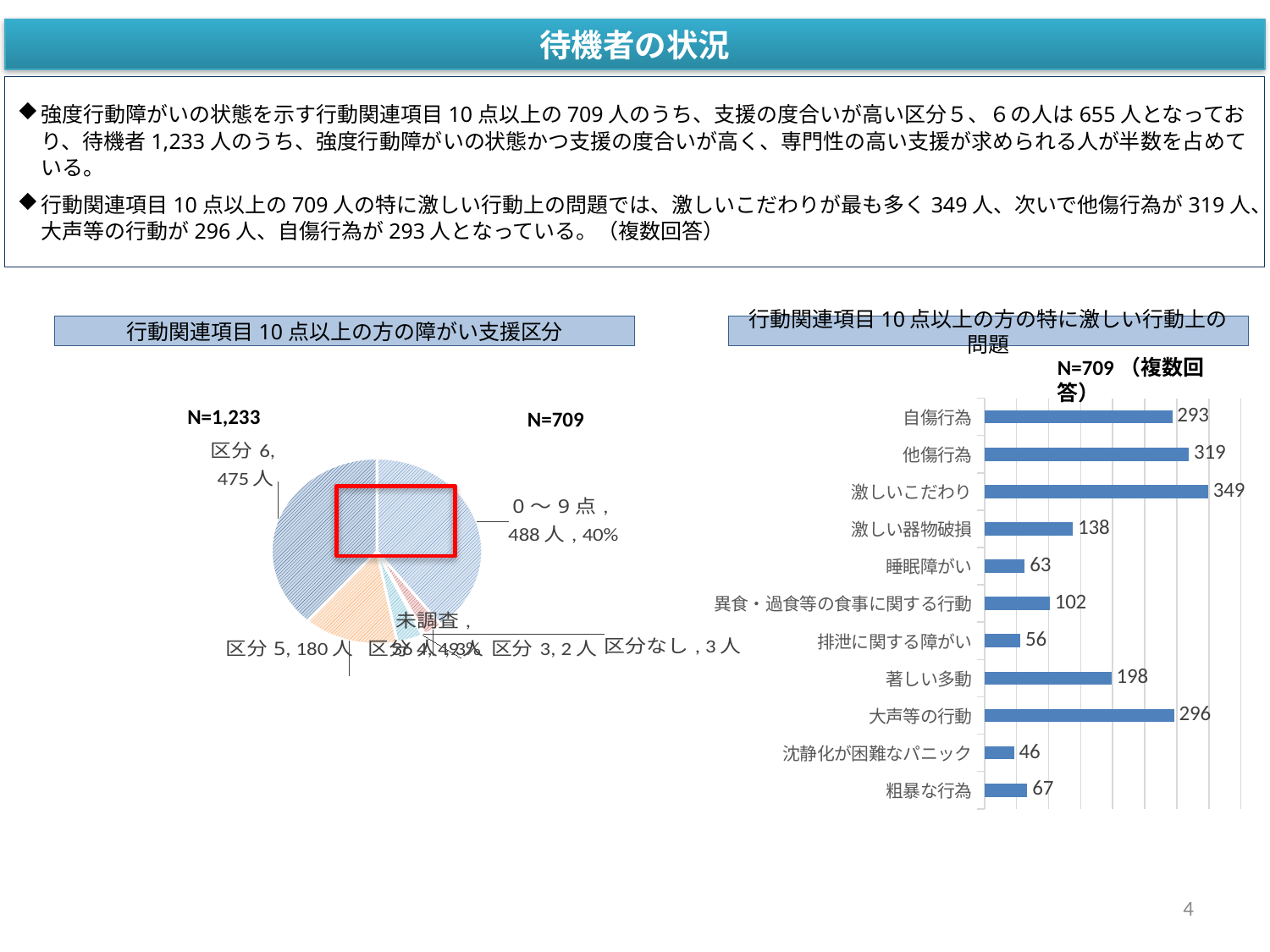
In the bar chart on the right, how many categories are shown? 11 What is the N value shown above the bar chart on the right? N=709 In the bar chart on the right, which is larger, 著しい多動 or 激しい器物破損? 著しい多動 What kind of chart is the chart on the right side of the slide? Bar chart In the bar chart on the right, which category has the lowest value? 沈静化が困難なパニック In the bar chart on the right (行動関連項目10点以上の方の特に激しい行動上の問題), what is the value for 激しいこだわり? 349 In the bar chart on the right, what is the value for 睡眠障がい? 63 In the pie chart on the left, what is the difference between the number of people in 区分6 and 区分5? 295人 In the bar chart on the right, what is the difference between the values for 他傷行為 and 自傷行為? 26 In the bar chart on the right, which category has the highest value? 激しいこだわり In the pie chart on the left, what share of the pie does the 0～9点 slice represent? 40% In the pie chart on the left (行動関連項目10点以上の方の障がい支援区分), how many people are in 区分6? 475人